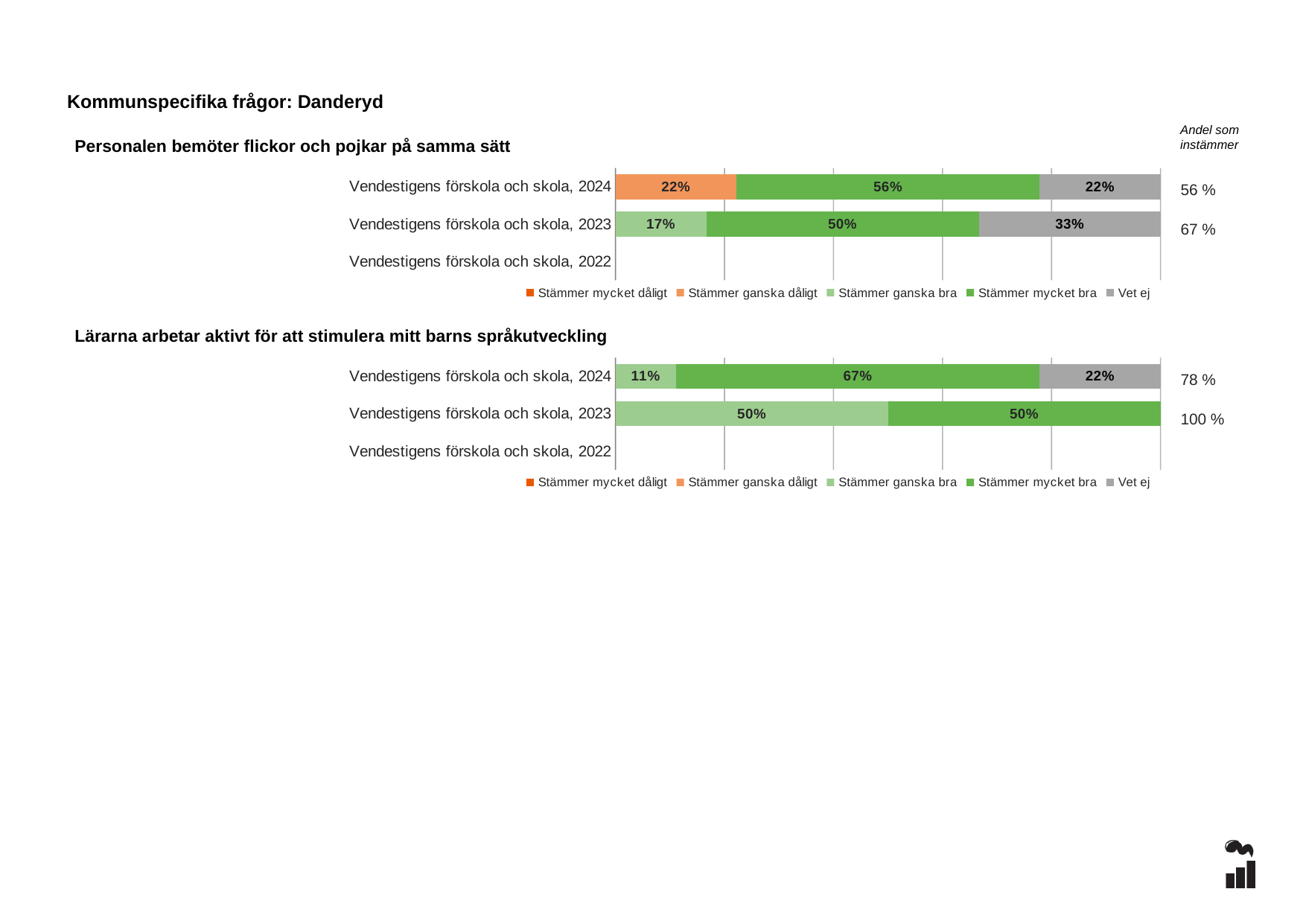
In the chart 'Lärarna arbetar aktivt för att stimulera mitt barns språkutveckling', which is larger for 2024: 'Stämmer ganska bra' or 'Vet ej'? Vet ej In the chart 'Lärarna arbetar aktivt för att stimulera mitt barns språkutveckling', what is the difference between the 'Stämmer mycket bra' values for 2024 and 2023? 17% In the chart 'Personalen bemöter flickor och pojkar på samma sätt', what is the 'Andel som instämmer' value shown for Vendestigens förskola och skola, 2023? 67 % In the chart 'Lärarna arbetar aktivt för att stimulera mitt barns språkutveckling', what is the 'Stämmer mycket bra' value for Vendestigens förskola och skola, 2024? 67% In the chart 'Personalen bemöter flickor och pojkar på samma sätt', what is the value for 'Stämmer mycket bra' for Vendestigens förskola och skola, 2024? 56% What kind of chart is 'Lärarna arbetar aktivt för att stimulera mitt barns språkutveckling'? Stacked bar chart In the chart 'Lärarna arbetar aktivt för att stimulera mitt barns språkutveckling', what is the 'Andel som instämmer' value shown for Vendestigens förskola och skola, 2023? 100 % In the chart 'Lärarna arbetar aktivt för att stimulera mitt barns språkutveckling', what is the 'Stämmer ganska bra' value for Vendestigens förskola och skola, 2023? 50% How many series does the legend list in the chart 'Personalen bemöter flickor och pojkar på samma sätt'? 5 In the chart 'Personalen bemöter flickor och pojkar på samma sätt', what is the 'Vet ej' value for Vendestigens förskola och skola, 2023? 33% In the chart 'Personalen bemöter flickor och pojkar på samma sätt', what is the 'Stämmer ganska dåligt' value for Vendestigens förskola och skola, 2024? 22% In the chart 'Personalen bemöter flickor och pojkar på samma sätt', what is the difference between the 'Vet ej' values for 2023 and 2024? 11%